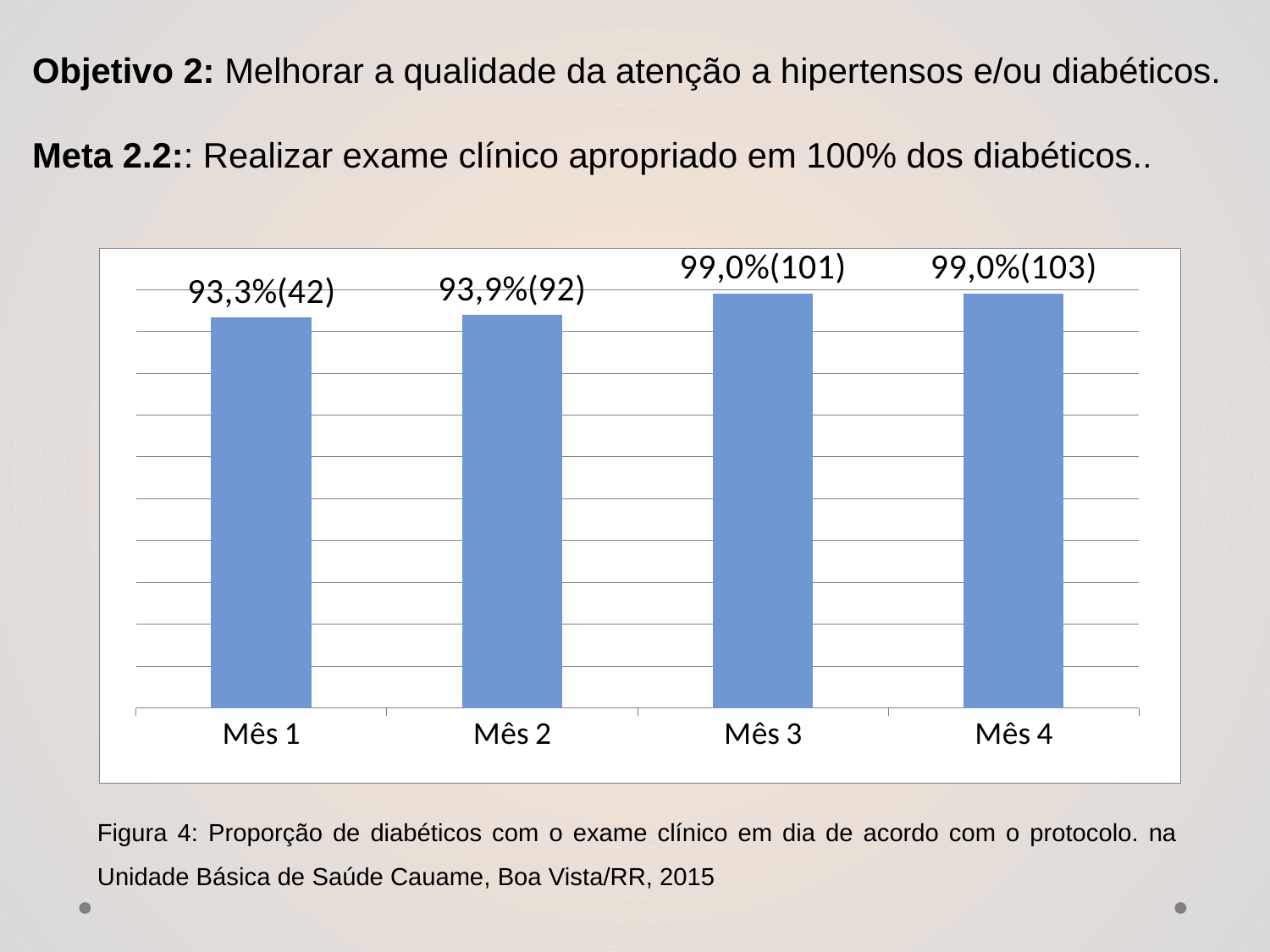
How many months (categories) are shown on the x axis? 4 What is the difference in percentage points between Mês 4 and Mês 1? 5,7 What percentage is shown for Mês 3? 99,0% Which is larger, the value for Mês 3 or the value for Mês 1? Mês 3 Do the values rise or fall from Mês 1 to Mês 4? Rise What value is shown for Mês 1? 93,3%(42) What is the difference in percentage points between Mês 2 and Mês 1? 0,6 What kind of chart is shown on the slide? Bar chart Which month has the lowest percentage? Mês 1 What is the number in parentheses for Mês 4? 103 What figure number is given in the caption below the chart? Figura 4 What value is shown for Mês 2? 93,9%(92)